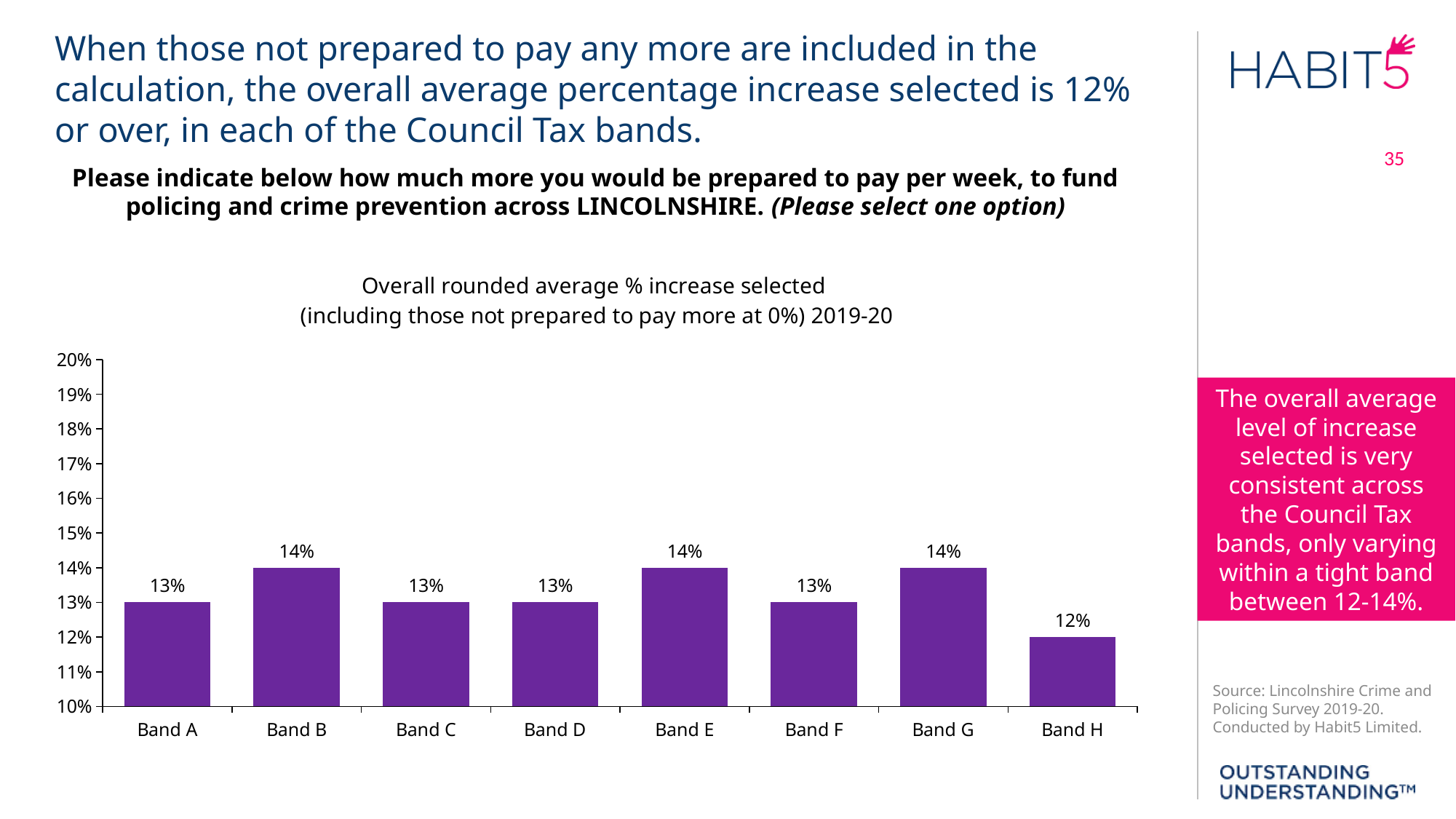
How many bands have a value of 14%? 3 What kind of chart is used to show the overall rounded average % increase selected? Bar chart What is the difference between the values for Band B and Band H? 2% What is the value shown for Band E? 14% Is the value for Band D greater or less than 15%? less What is the overall rounded average % increase selected for Band H? 12% How many Council Tax bands are shown on the x axis of the chart? 8 What is the overall rounded average % increase selected for Band A? 13% What colour are the bars in the chart? Purple What is the highest value shown on the chart's vertical axis? 20% Which is larger, the value for Band G or the value for Band F? Band G Which Council Tax band has the lowest overall rounded average % increase selected? Band H